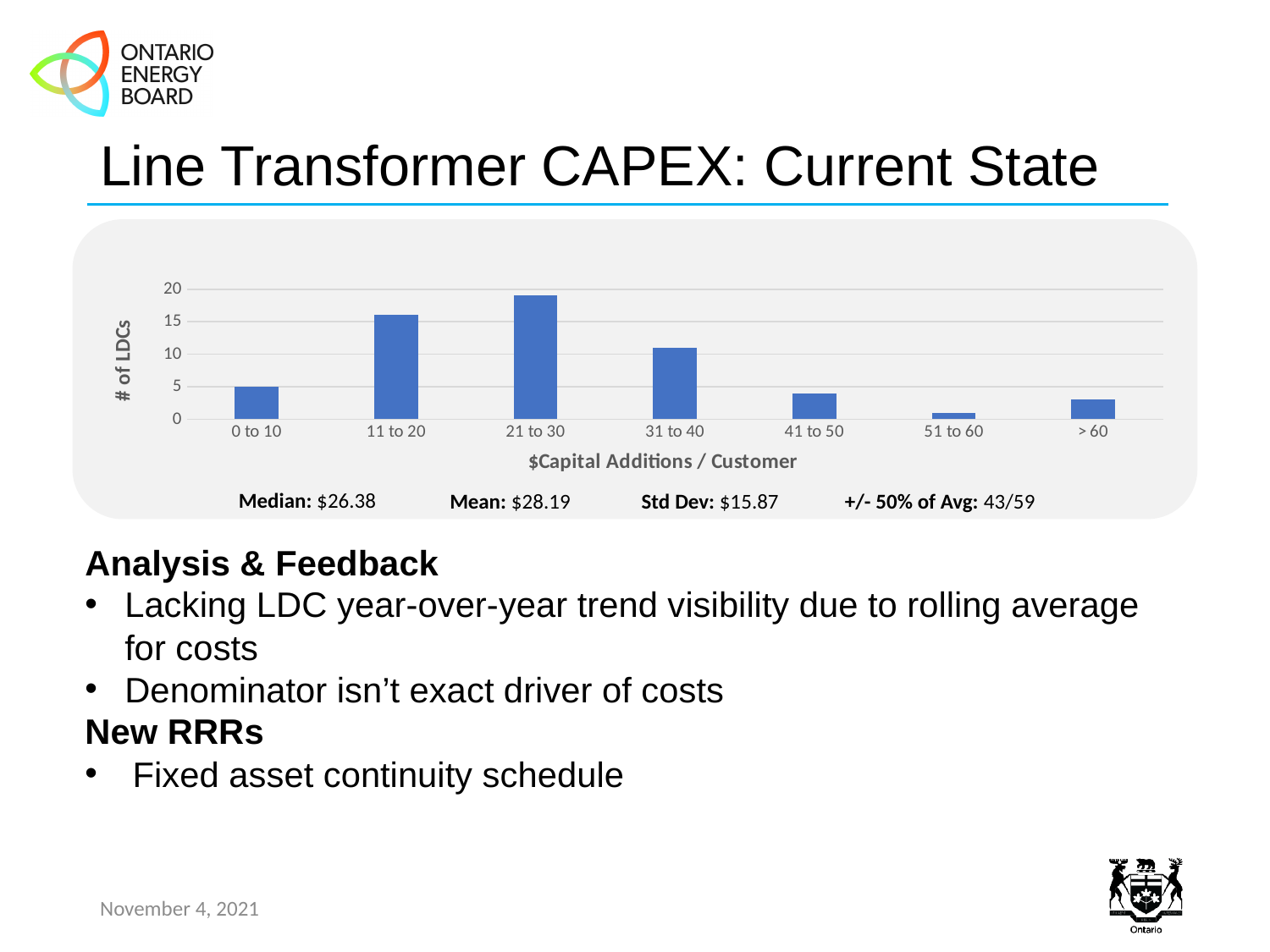
Is the value for 31 to 40 greater or less than 15? less Which category has more LDCs, 11 to 20 or 31 to 40? 11 to 20 Is the value for 11 to 20 greater or less than 10? greater What kind of chart is shown on the slide? bar chart Which category has the lowest number of LDCs? 51 to 60 How many categories are shown on the x axis of the chart? 7 Which category has the highest number of LDCs? 21 to 30 Which category has more LDCs, 41 to 50 or > 60? 41 to 50 Is the value for 21 to 30 greater or less than 15? greater What is the title of the horizontal axis of the chart? $Capital Additions / Customer What is the title of the vertical axis of the chart? # of LDCs